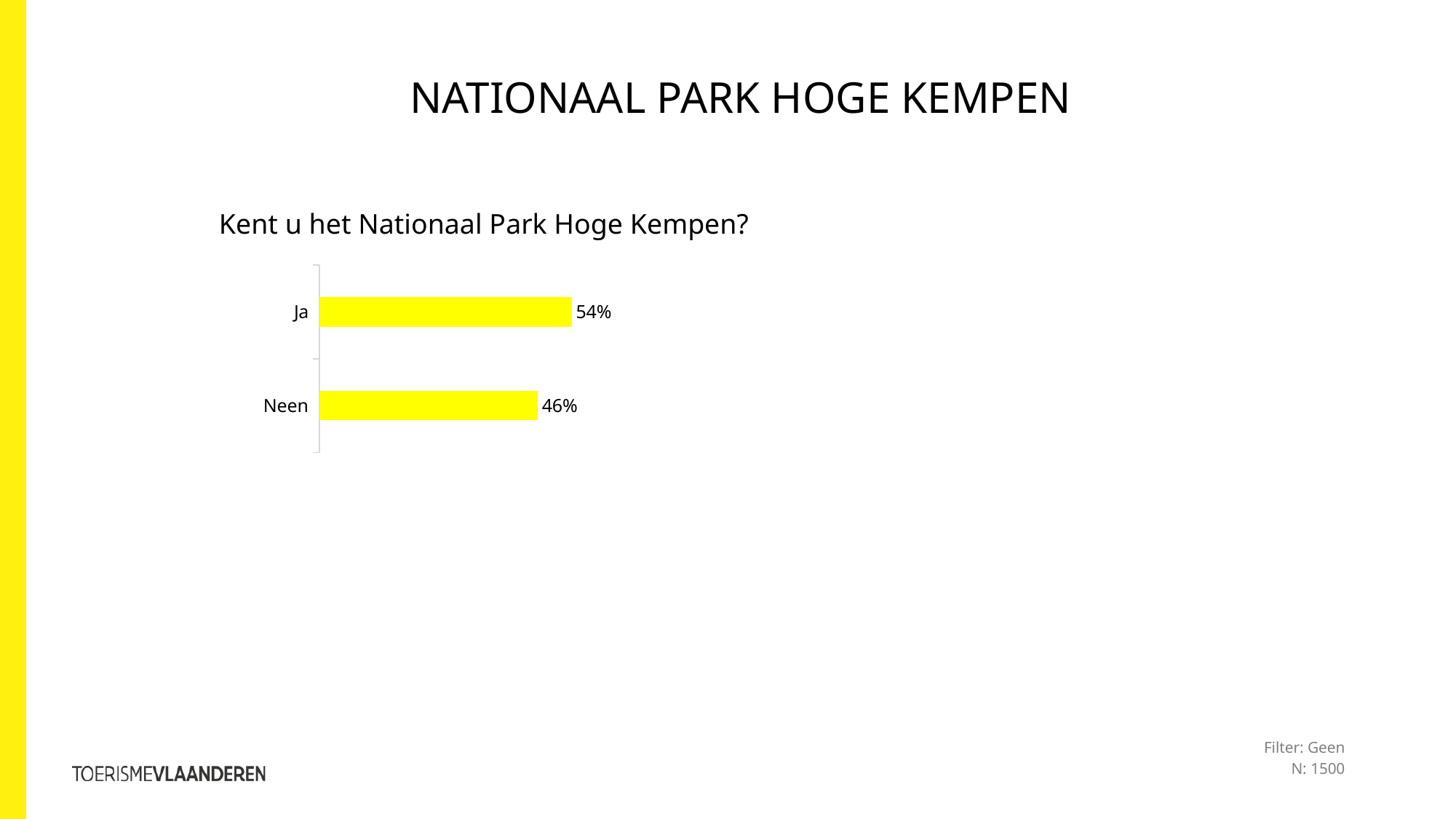
What is the value for Neen? 46% Which category has the lowest value? Neen What question does the chart answer, as written above it? Kent u het Nationaal Park Hoge Kempen? Which is larger, the value for Ja or the value for Neen? Ja What is the total of the values for Ja and Neen? 100% How many categories are shown in the chart? 2 What is the value for Ja? 54% Which category has the highest value? Ja What kind of chart is shown on the slide? bar chart What is the difference between the values for Ja and Neen? 8% What colour are the bars in the chart? yellow